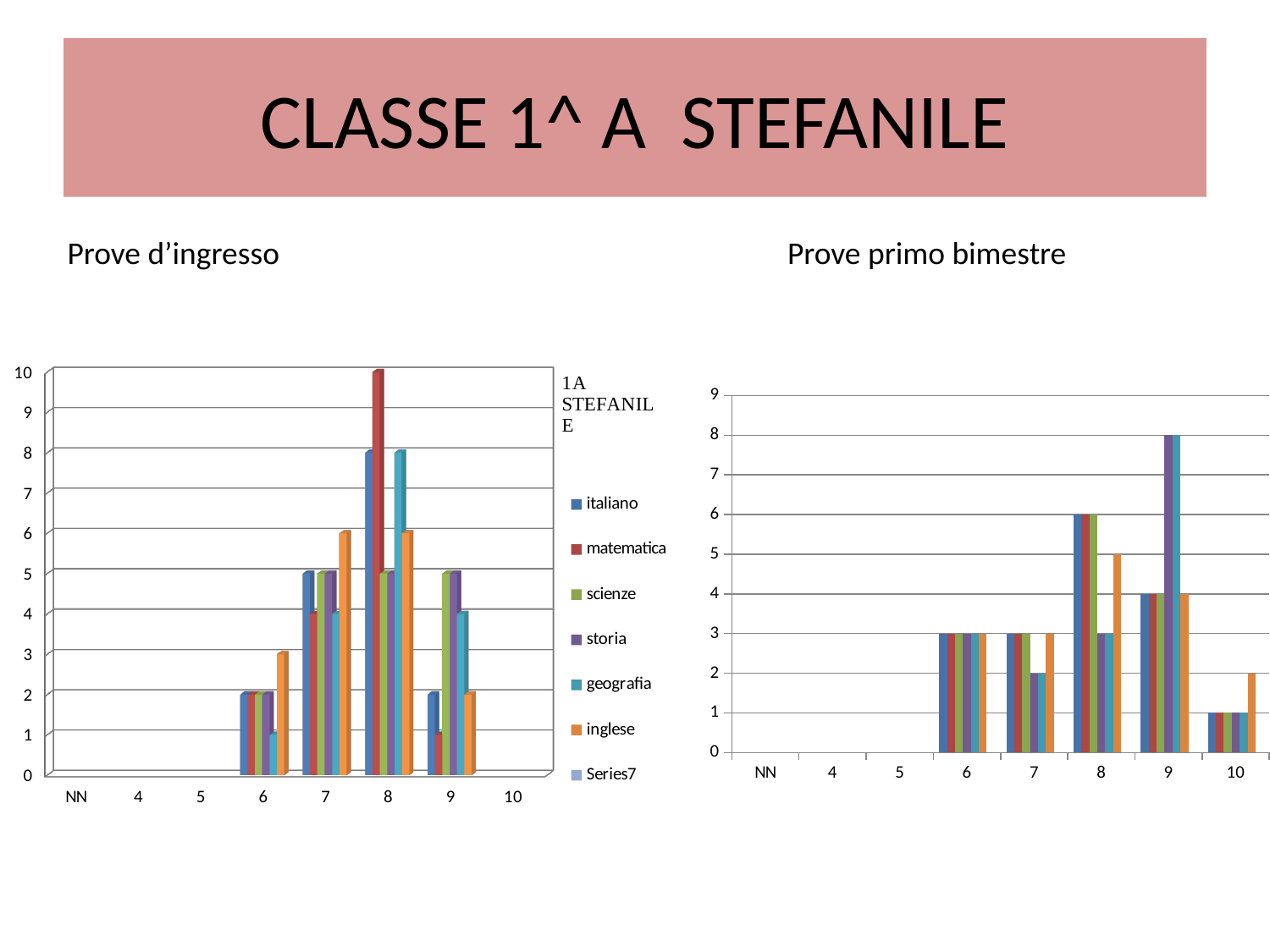
In the 'Prove d'ingresso' chart, what is the difference between matematica and scienze at category 8? 5 What kind of chart is the 'Prove d'ingresso' chart on the left? bar chart In the 'Prove primo bimestre' chart on the right, what is the highest value reached by any bar? 8 How many categories are shown on the x axis of the 'Prove d'ingresso' chart? 8 In the 'Prove d'ingresso' chart, at category 8, which is larger: italiano or scienze? italiano How many series does the legend of the 'Prove d'ingresso' chart list? 7 In the 'Prove primo bimestre' chart on the right, which category contains the tallest bars? 9 In the 'Prove d'ingresso' chart, which category has the highest value for matematica? 8 In the 'Prove d'ingresso' chart, what is the value for inglese at category 7? 6 What title is shown above the legend of the 'Prove d'ingresso' chart? 1A STEFANILE In the 'Prove d'ingresso' chart, is the value for geografia at category 8 greater or less than 5? greater In the 'Prove d'ingresso' chart, what is the value for matematica at category 8? 10